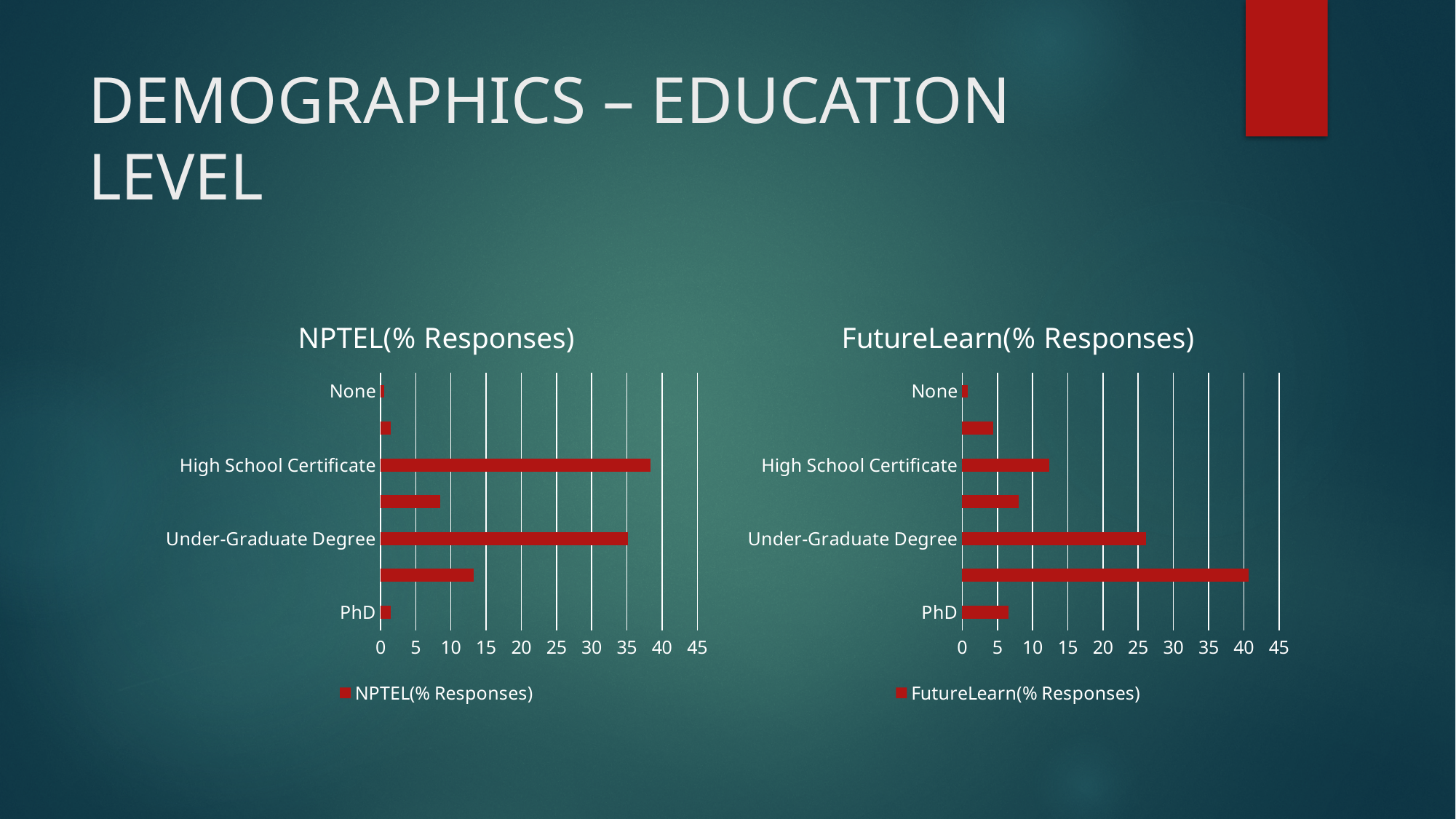
In the FutureLearn(% Responses) chart, which is larger, Under-Graduate Degree or High School Certificate? Under-Graduate Degree In the FutureLearn(% Responses) chart, which labelled category has the lowest value? None How many bars are plotted in the NPTEL(% Responses) chart? 7 What is the title of the chart on the right side of the slide? FutureLearn(% Responses) In the NPTEL(% Responses) chart, is the value for PhD greater or less than 5? less In the FutureLearn(% Responses) chart, is the value for Under-Graduate Degree greater or less than 25? greater What kind of chart is the NPTEL(% Responses) chart? bar chart In the FutureLearn(% Responses) chart, is the value for High School Certificate greater or less than 15? less How many series does the legend of the FutureLearn(% Responses) chart list? 1 In the NPTEL(% Responses) chart, which is larger, High School Certificate or Under-Graduate Degree? High School Certificate